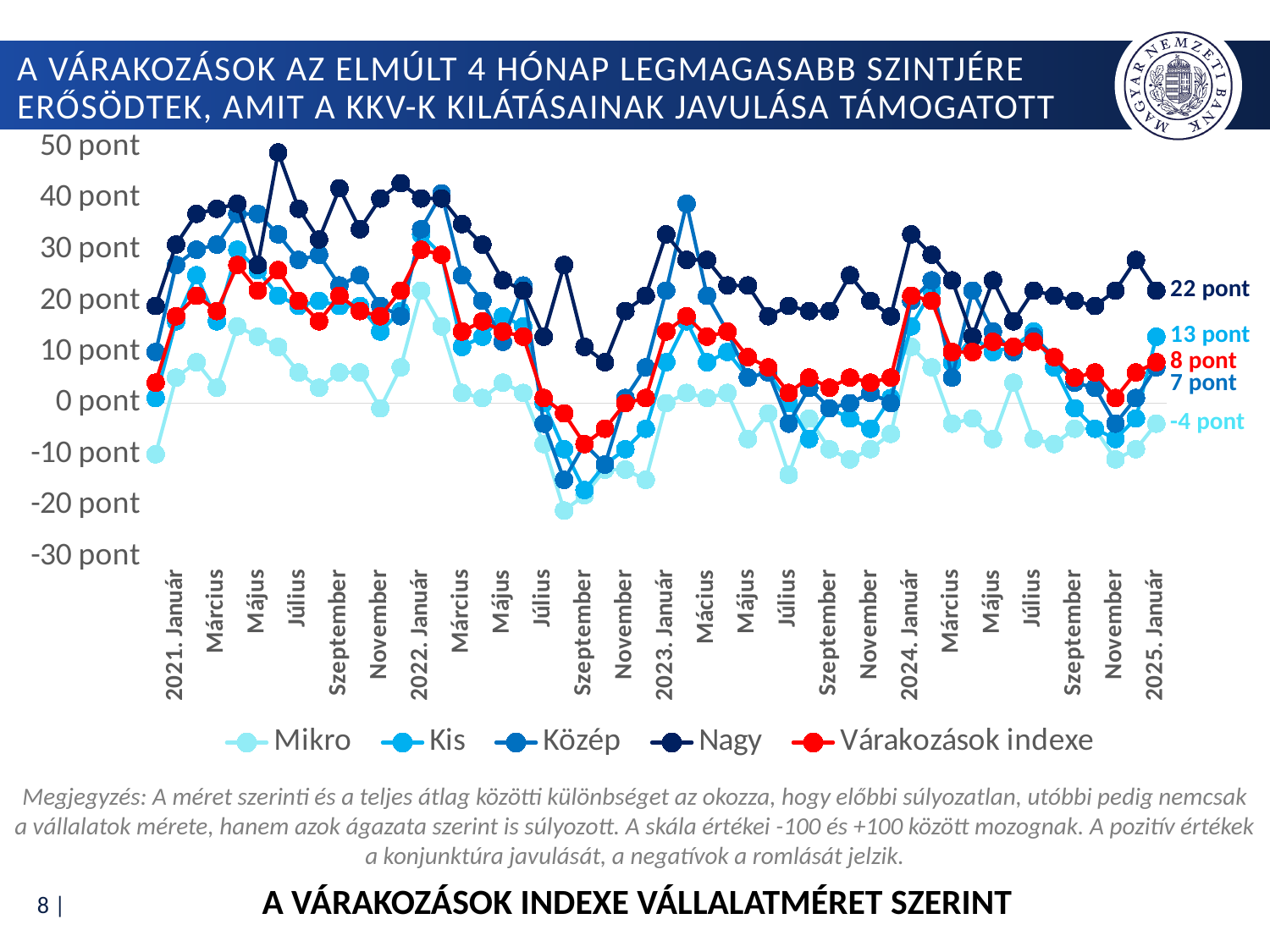
What is the value of the Nagy series at 2025. Január? 22 pont What kind of chart is shown on the slide? Line chart Is the value for Mikro at 2021. Január greater or less than 0 pont? greater Which series has the lowest value at 2025. Január? Mikro What is the value of the Várakozások indexe series at 2025. Január? 8 pont What is the difference between the Nagy and Kis values at 2025. Január? 9 pont What is the value of the Kis series at 2025. Január? 13 pont How many series does the legend list? 5 What is the value of the Mikro series at 2025. Január? -4 pont At 2025. Január, which is larger: the Kis value or the Közép value? Kis What is the value of the Közép series at 2025. Január? 7 pont Which series has the highest value at 2025. Január? Nagy